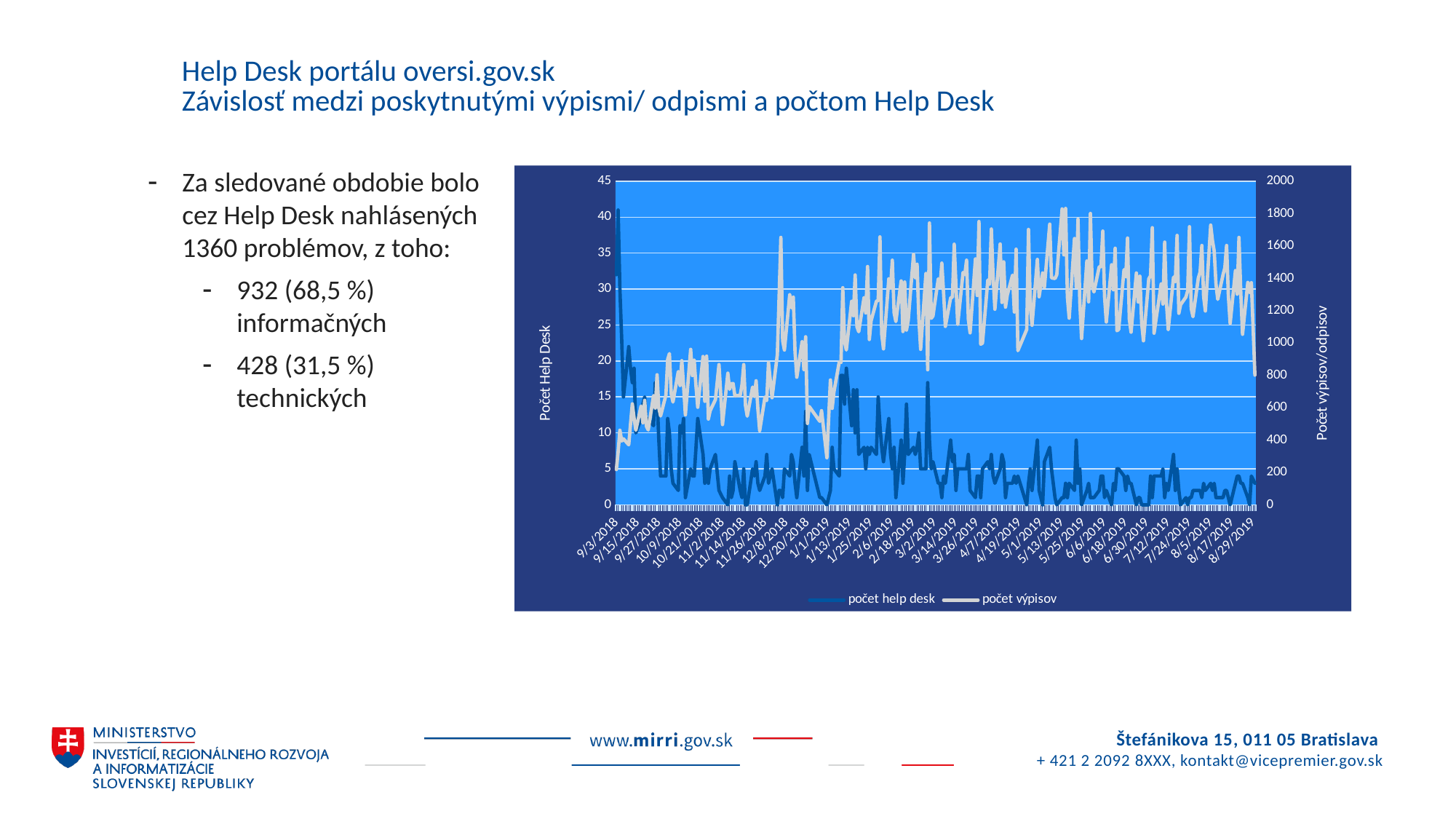
Is the 'počet help desk' value at 9/3/2018 greater or less than 35? less Is the 'počet výpisov' value at 8/29/2019 greater or less than 400? greater Is the 'počet help desk' value at 8/29/2019 greater or less than 10? less What is the title of the right-hand vertical axis of the chart? Počet výpisov/odpisov Does the 'počet help desk' series generally rise or fall from 9/3/2018 to 8/29/2019? fall What kind of chart is shown on the slide? line chart How many series does the chart legend list? 2 What are the two series named in the chart legend? počet help desk, počet výpisov Does the 'počet výpisov' series generally rise or fall from 9/3/2018 to 8/29/2019? rise